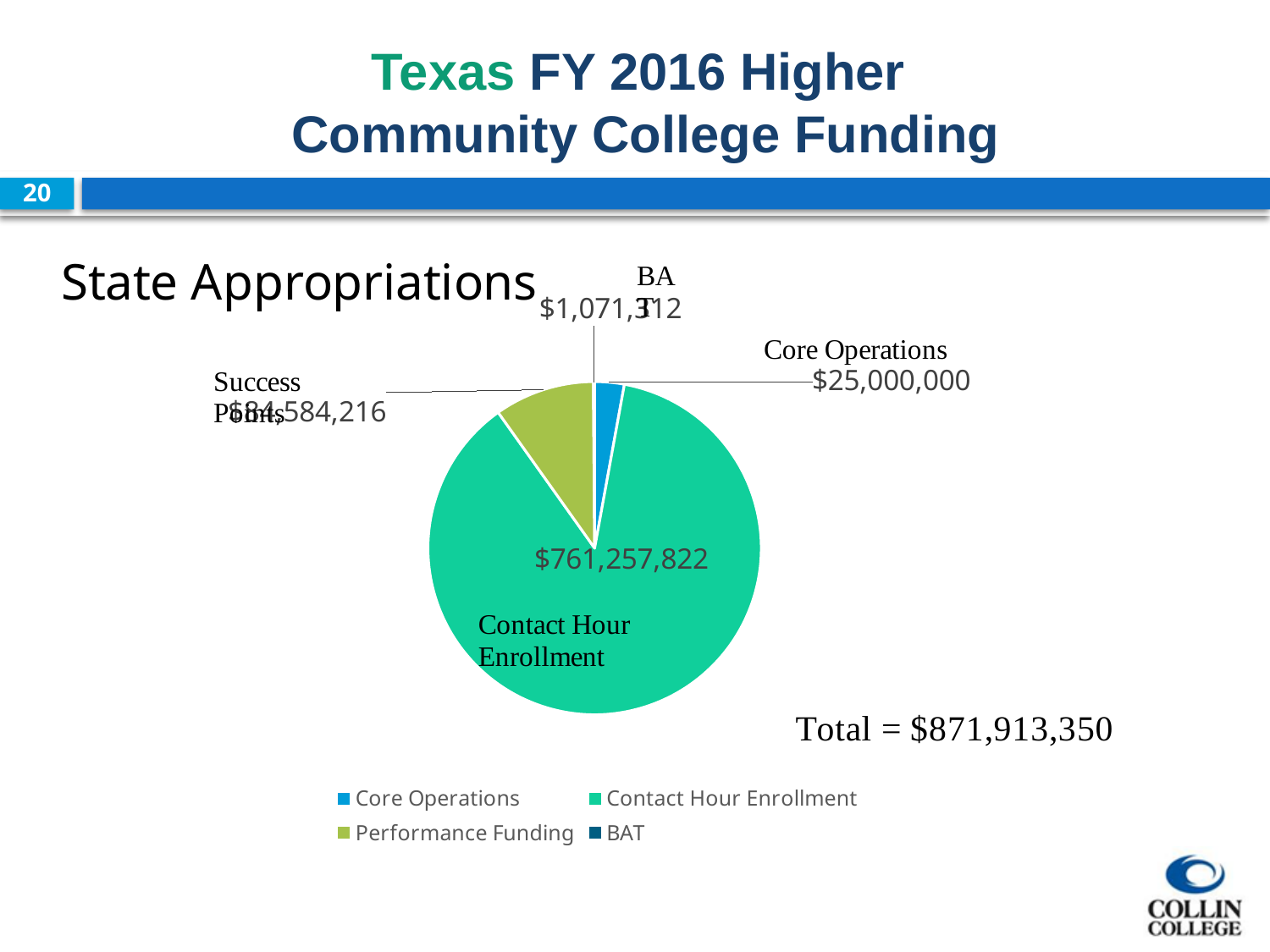
Which category has the smallest slice of the pie? BAT Which category has the largest slice of the pie? Contact Hour Enrollment What is the value of the Contact Hour Enrollment slice? $761,257,822 How many slices does the pie chart have? 4 What is the value of the Performance Funding slice? $84,584,216 What is the value of the Core Operations slice? $25,000,000 What is the difference between the Contact Hour Enrollment value and the Core Operations value? $736,257,822 Which is larger, Core Operations or Performance Funding? Performance Funding What is the total of all state appropriations shown on the slide? $871,913,350 How many entries does the legend list? 4 What is the title of the pie chart? State Appropriations What kind of chart is shown on the slide? pie chart